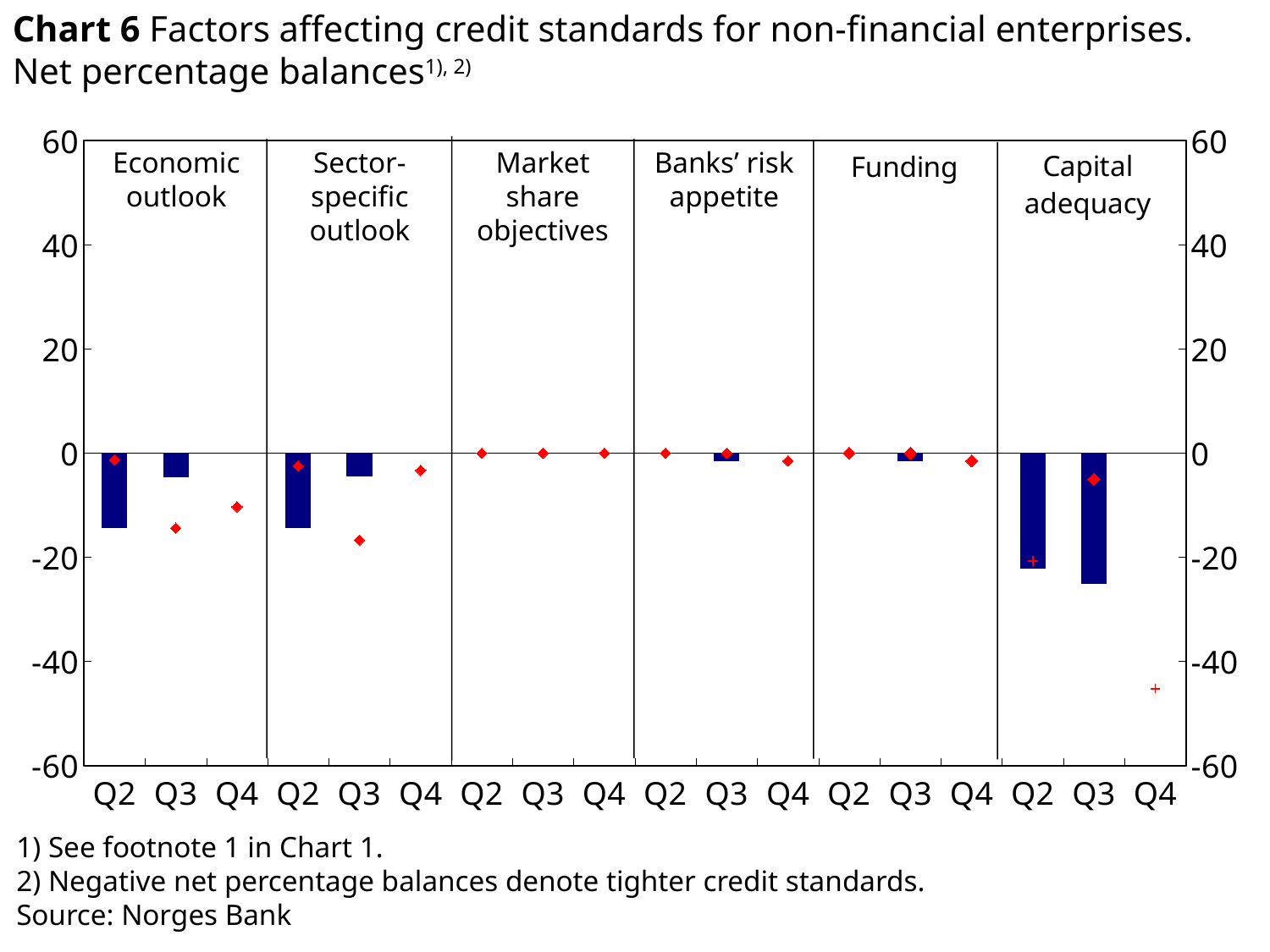
Is the Q3 marker in the Sector-specific outlook panel greater or less than -10? less How many quarters are shown on the x axis within each factor panel? 3 Is the Q2 bar in the Economic outlook panel greater or less than -20? greater What kind of chart is shown on the slide? Bar chart In the Capital adequacy panel, which bar is lower (more negative), Q2 or Q3? Q3 What is the source given for the chart? Norges Bank How many factor panels are shown in the chart? 6 What is the maximum value shown on the vertical axis? 60 Is the Q4 marker in the Capital adequacy panel greater or less than -40? less In the Economic outlook panel, which bar is larger (less negative), Q2 or Q3? Q3 Which factor panel contains the lowest (most negative) bar in the chart? Capital adequacy